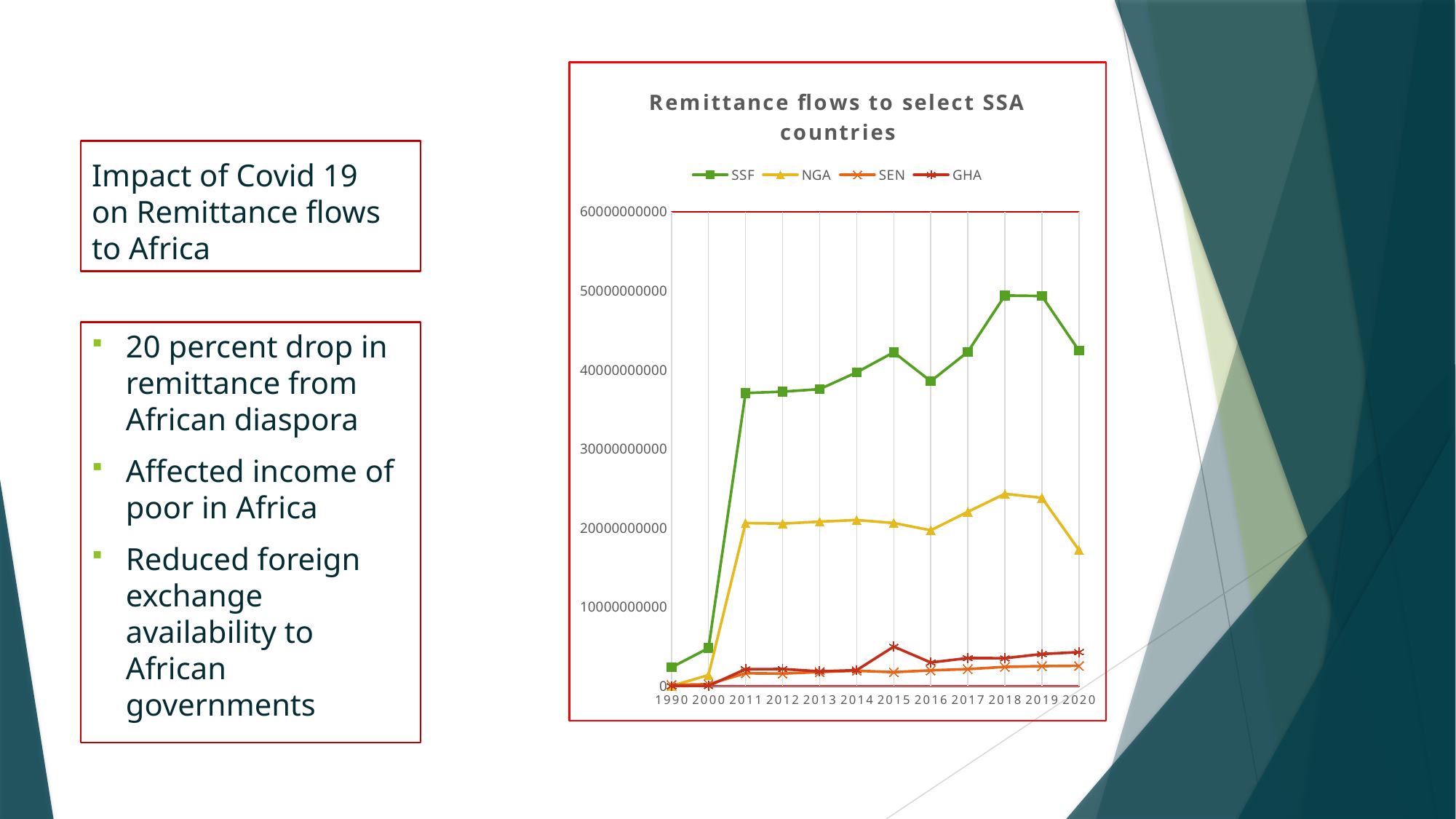
Does the SSF series rise or fall between 2019 and 2020? fall How many series does the chart legend list? 4 Which series has the highest values across the chart? SSF Which series has the larger value in 2015, NGA or GHA? NGA How many years are shown on the x axis of the chart? 12 Is the NGA value for 2020 greater or less than 20000000000? less What is the title of the chart? Remittance flows to select SSA countries Which series is drawn in green on the chart? SSF Is the SSF value for 2000 greater or less than 10000000000? less Is the SSF value for 2018 greater or less than 40000000000? greater Which series has the lowest values in 2020? SEN What kind of chart is shown on the slide? line chart